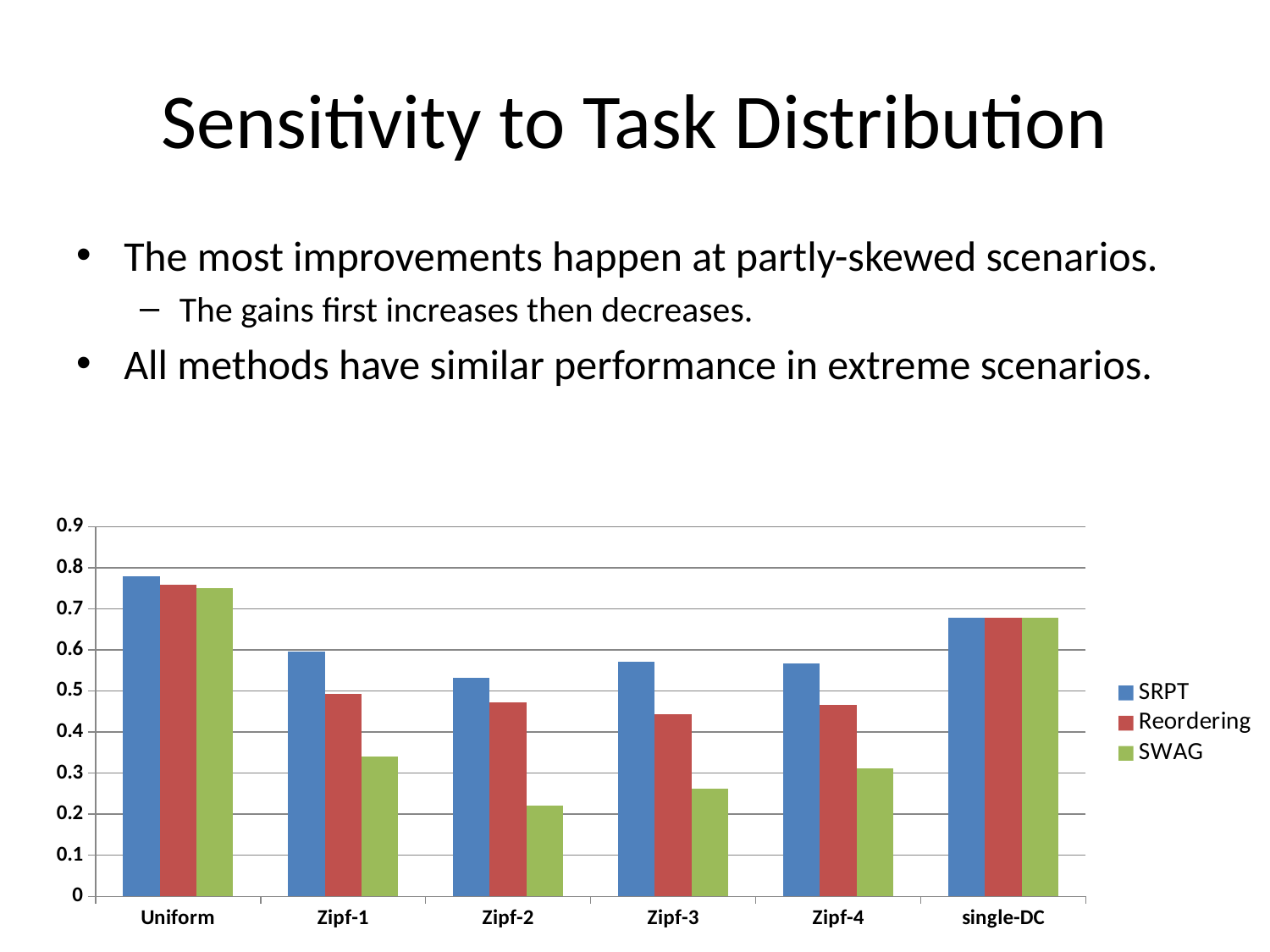
How many series does the legend list? 3 Is the SWAG value for single-DC greater or less than 0.6? greater Which is larger: the SWAG value for Zipf-4 or for Zipf-2? Zipf-4 Which is larger: the Reordering value for Zipf-1 or for Zipf-3? Zipf-1 Which series are listed in the legend? SRPT, Reordering, SWAG For which category is the SWAG value lowest? Zipf-2 What kind of chart is shown on the slide? bar chart Is the SWAG value for Zipf-1 greater or less than 0.4? less Is the SRPT value for Zipf-2 greater or less than 0.5? greater For which category is the SRPT value highest? Uniform How many categories are shown on the x axis? 6